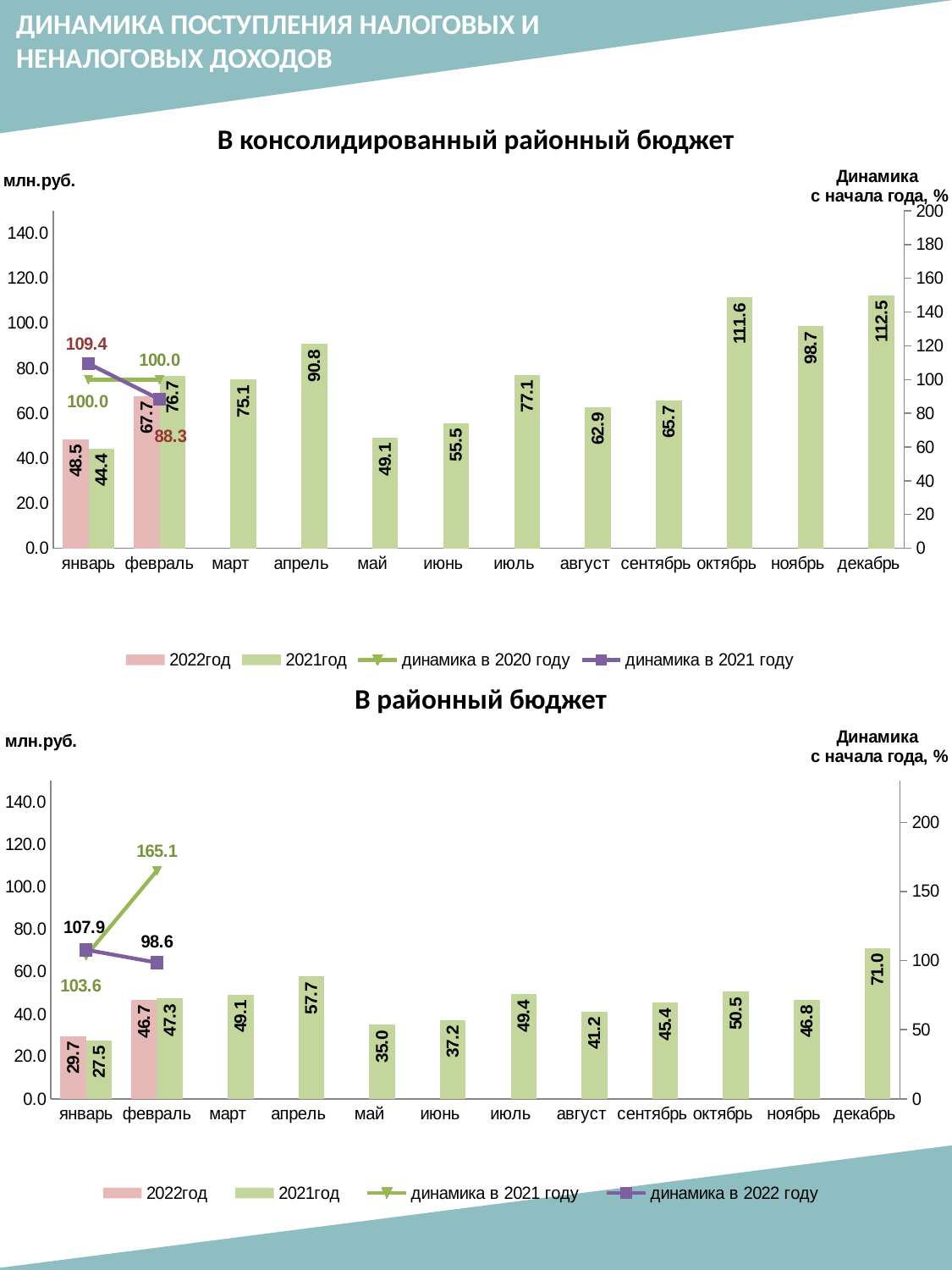
In the chart 'В консолидированный районный бюджет', how many series does the legend list? 4 In the chart 'В районный бюджет', how many months are shown on the x axis? 12 In the chart 'В консолидированный районный бюджет', what is the 2022год value for февраль? 67.7 In the chart 'В районный бюджет', what is the 2021год value for декабрь? 71.0 In the chart 'В консолидированный районный бюджет', which month has the lowest 2021год value? январь In the chart 'В консолидированный районный бюджет', what is the 2021год value for октябрь? 111.6 In the chart 'В районный бюджет', which month has the lowest 2021год value? январь In the chart 'В консолидированный районный бюджет', what is the value of 'динамика в 2021 году' for февраль? 88.3 In the chart 'В районный бюджет', what is the value of 'динамика в 2021 году' for февраль? 165.1 In the chart 'В консолидированный районный бюджет', what is the difference between the 2022год and 2021год values for январь? 4.1 In the chart 'В районный бюджет', which is larger for февраль: the 2022год value or the 2021год value? 2021год In the chart 'В консолидированный районный бюджет', which month has the highest 2021год value? декабрь